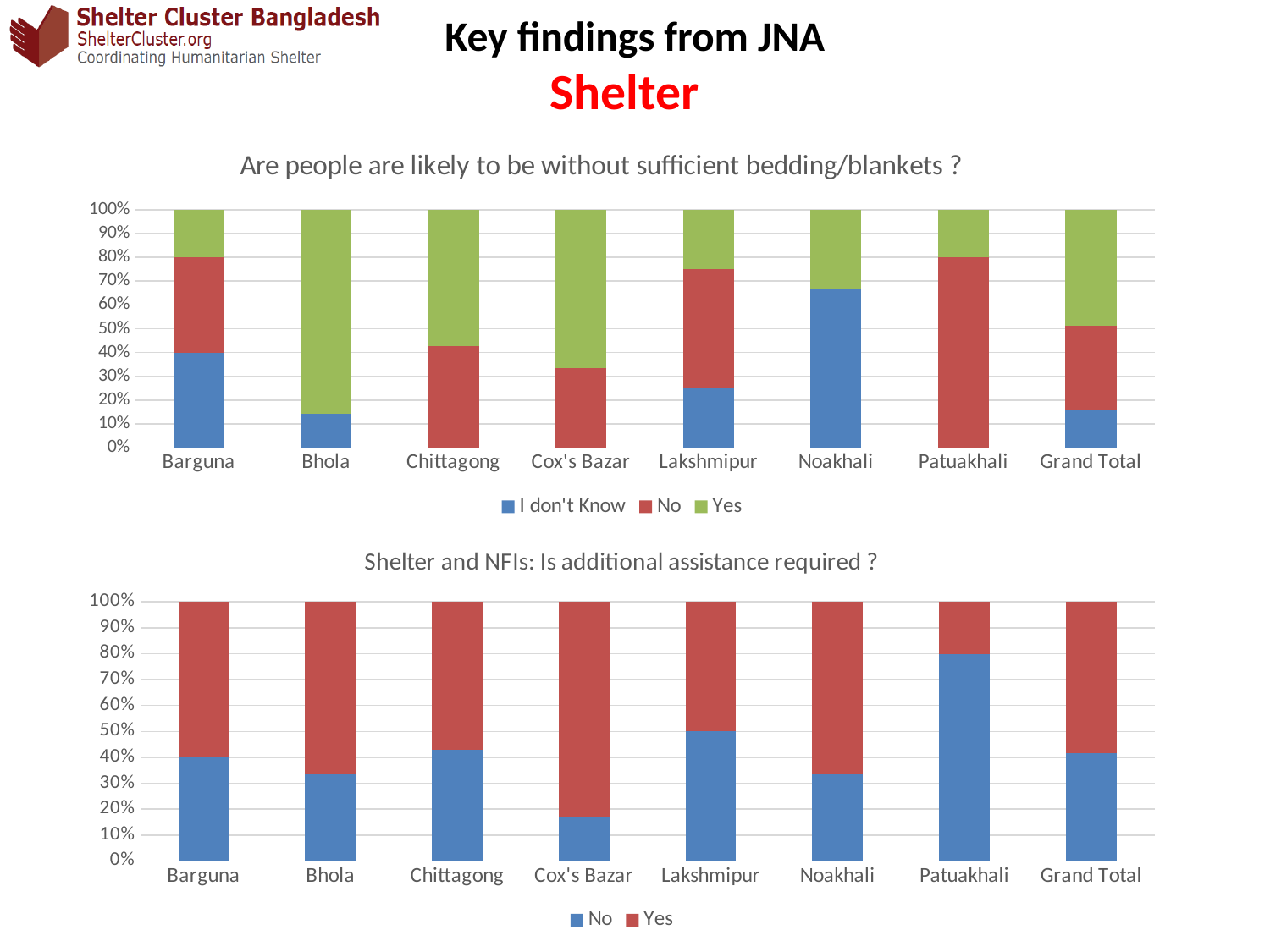
In the top chart, how many categories are shown on the x axis? 8 What kind of chart is the bottom chart 'Shelter and NFIs: Is additional assistance required ?'? Stacked bar chart In the bottom chart, is the 'No' share for Cox's Bazar greater or less than 20%? less In the top chart, is the 'I don't Know' share for Noakhali greater or less than 60%? greater In the top chart 'Are people are likely to be without sufficient bedding/blankets ?', how many series does the legend list? 3 In the top chart, which category has the largest 'I don't Know' share? Noakhali In the top chart, which category has the largest 'Yes' share? Bhola In the bottom chart, which is larger: the 'No' share for Chittagong or the 'No' share for Cox's Bazar? Chittagong In the bottom chart 'Shelter and NFIs: Is additional assistance required ?', how many series does the legend list? 2 In the top chart, which category has the largest 'No' share? Patuakhali In the bottom chart, which category has the smallest 'No' share? Cox's Bazar